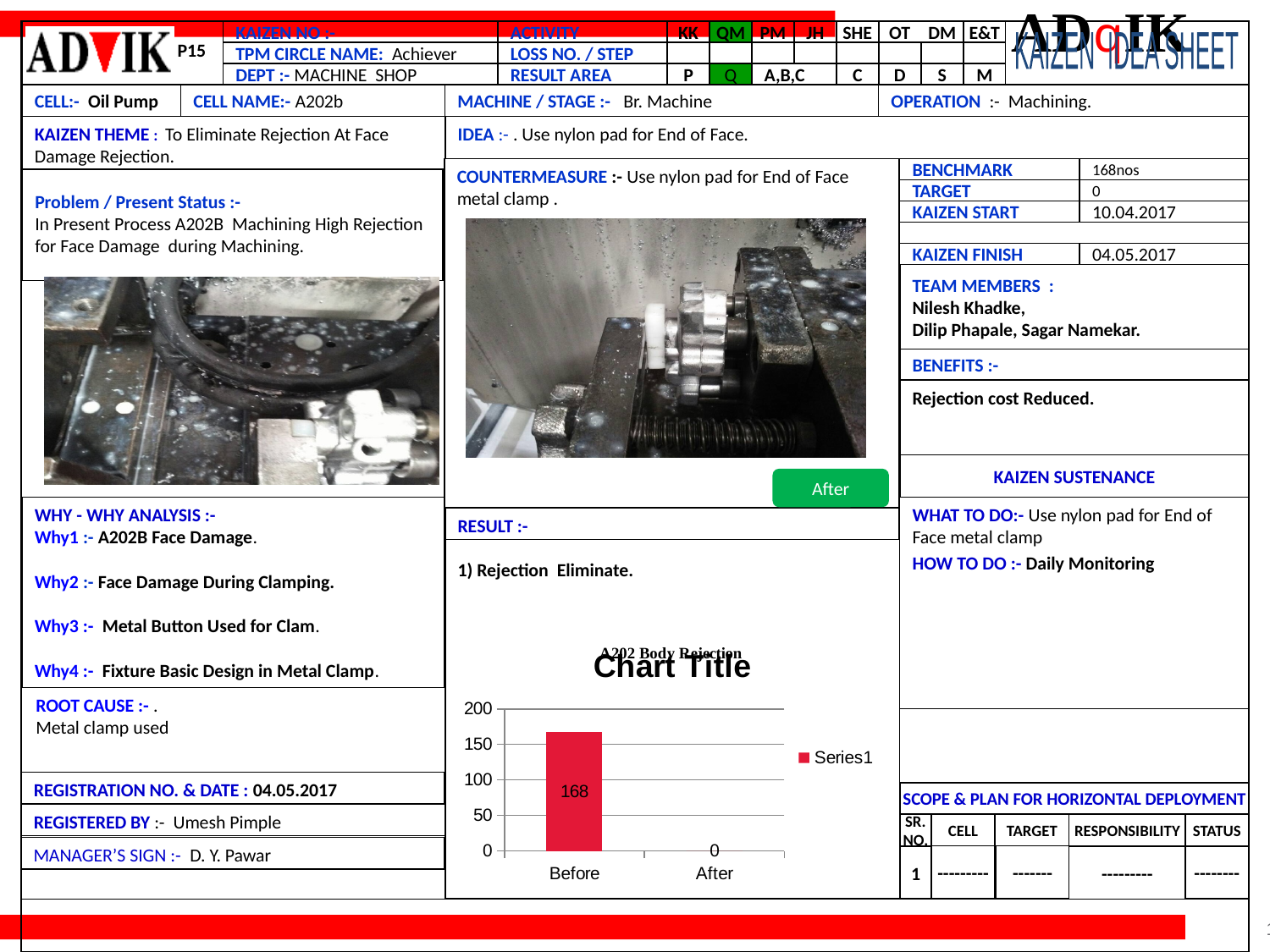
Which category has the highest value in the chart? Before What is the difference between the Before and After values in the chart? 168 Do the values rise or fall from Before to After in the chart? fall Is the value for Before in the chart greater or less than 150? greater How many series does the chart legend list? 1 What kind of chart is shown on the slide? bar chart Which is larger in the chart, the value for Before or the value for After? Before Which category has the lowest value in the chart? After How many categories are shown on the x axis of the chart? 2 What is the value for After in the chart? 0 What is the value for Before in the chart? 168 What series name is shown in the chart legend? Series1